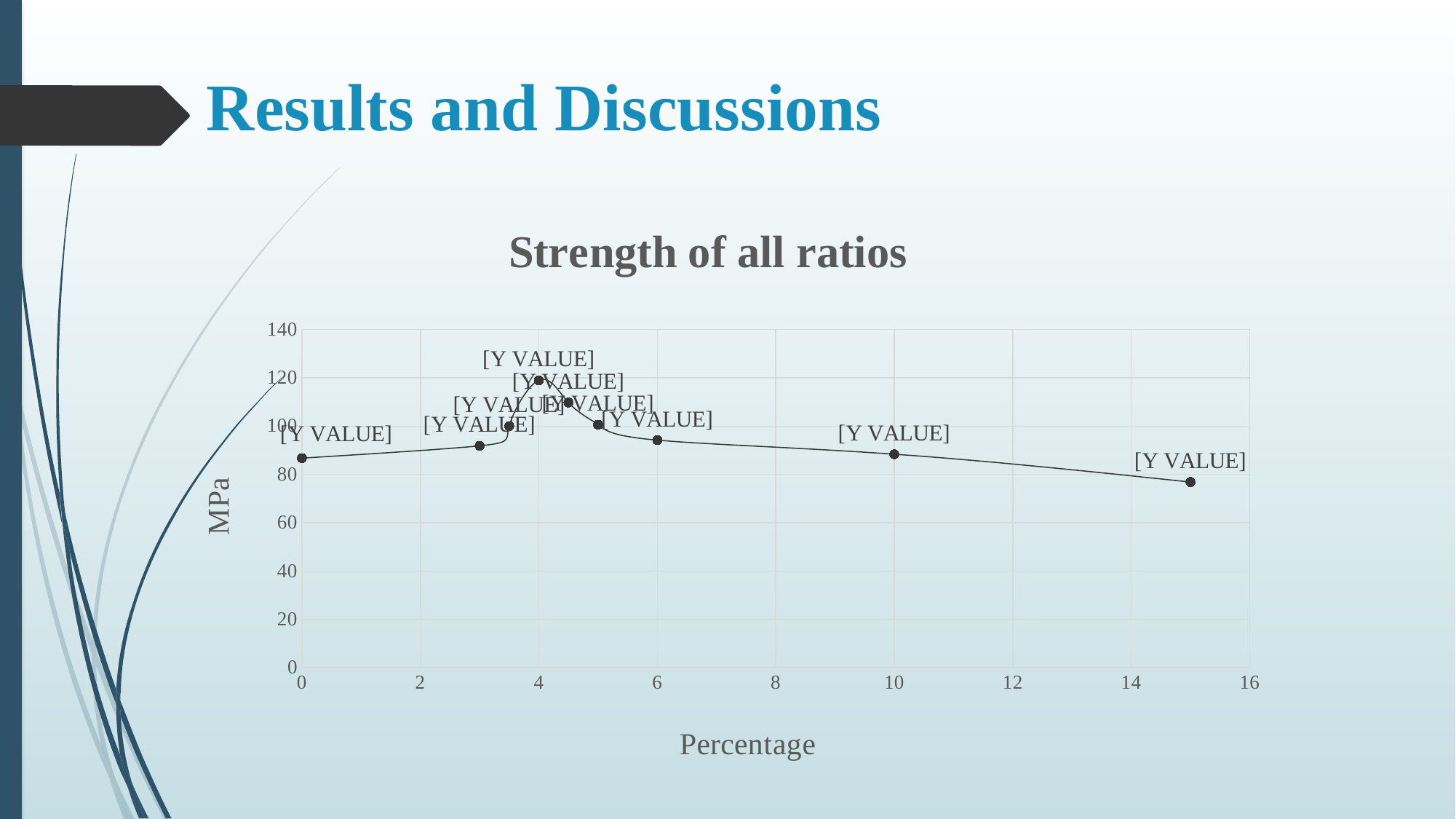
Is the value at Percentage 0 greater or less than 80? greater At which Percentage value does the chart reach its lowest MPa? 15 Is the value at Percentage 4 greater or less than 100? greater What is the title of the chart? Strength of all ratios What kind of chart is shown on the slide? line chart How many data points are plotted on the chart? 9 Do the values rise or fall as Percentage increases from 4 to 15? fall Is the value at Percentage 10 greater or less than 100? less At which Percentage value does the chart reach its highest MPa? 4 Which has the larger MPa value: Percentage 0 or Percentage 15? Percentage 0 What label is shown on the vertical axis of the chart? MPa